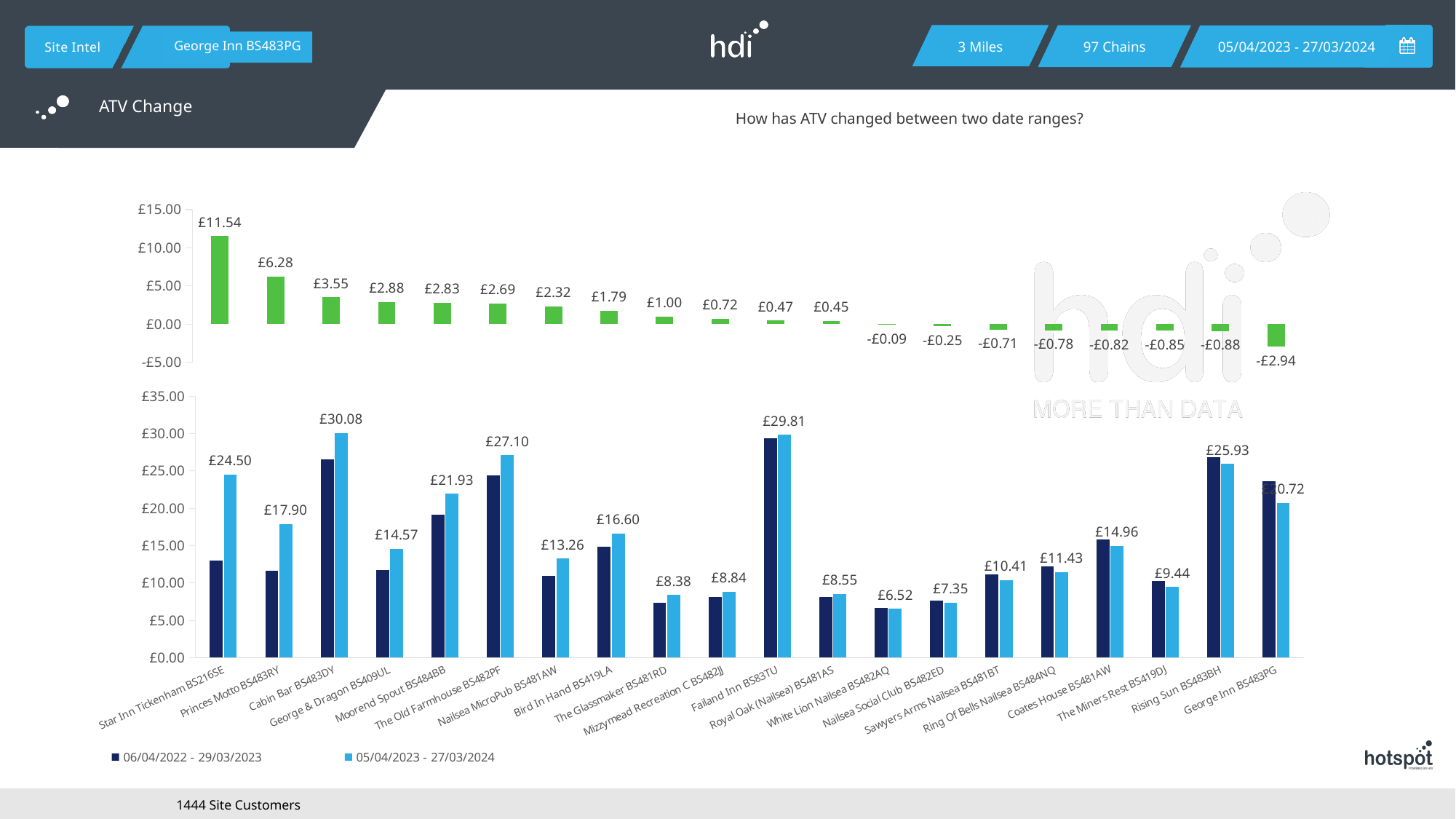
In the top chart, what is the highest value shown? £11.54 In the bottom chart, which category has the highest value in the 05/04/2023 - 27/03/2024 series? Cabin Bar BS483DY In the bottom chart, what is the difference between the 05/04/2023 - 27/03/2024 values for Cabin Bar BS483DY and Failand Inn BS83TU? £0.27 In the bottom chart, what is the value for Cabin Bar BS483DY in the 05/04/2023 - 27/03/2024 series? £30.08 In the bottom chart, for George Inn BS483PG, which series has the larger value? 06/04/2022 - 29/03/2023 How many series does the legend of the bottom chart list? 2 In the bottom chart, what is the value for Failand Inn BS83TU in the 05/04/2023 - 27/03/2024 series? £29.81 In the bottom chart, is the 06/04/2022 - 29/03/2023 value for Star Inn Tickenham BS216SE greater or less than £15.00? less In the bottom chart, what is the value for George Inn BS483PG in the 05/04/2023 - 27/03/2024 series? £20.72 In the top chart, what is the lowest value shown? -£2.94 In the bottom chart, which category has the lowest value in the 05/04/2023 - 27/03/2024 series? White Lion Nailsea BS482AQ How many categories are shown on the x axis of the bottom chart? 20